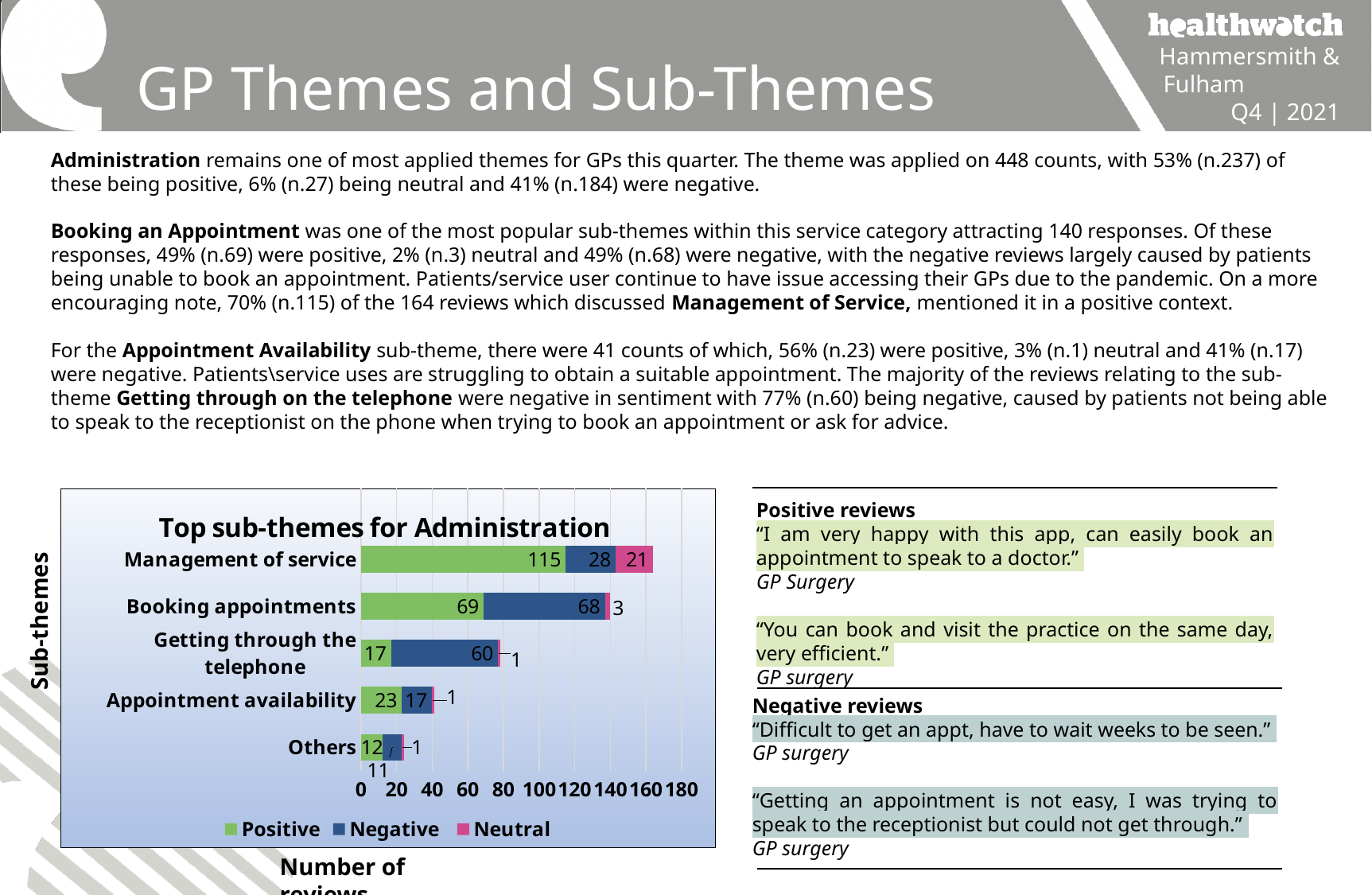
Which sub-theme has the highest Negative value in the 'Top sub-themes for Administration' chart? Booking appointments How many sub-theme categories are shown in the 'Top sub-themes for Administration' chart? 5 What is the total of the stacked bar for Appointment availability in the 'Top sub-themes for Administration' chart? 41 How many series does the legend of the 'Top sub-themes for Administration' chart list? 3 What is the total of the stacked bar for Booking appointments in the 'Top sub-themes for Administration' chart? 140 What is the Negative value for Getting through the telephone in the 'Top sub-themes for Administration' chart? 60 What is the difference between the Positive values for Management of service and Booking appointments in the 'Top sub-themes for Administration' chart? 46 What is the Positive value for Management of service in the 'Top sub-themes for Administration' chart? 115 What is the Neutral value for Management of service in the 'Top sub-themes for Administration' chart? 21 Which sub-theme has the highest Positive value in the 'Top sub-themes for Administration' chart? Management of service In the 'Top sub-themes for Administration' chart, which is larger for Getting through the telephone: the Positive value or the Negative value? Negative What type of chart is 'Top sub-themes for Administration'? stacked bar chart